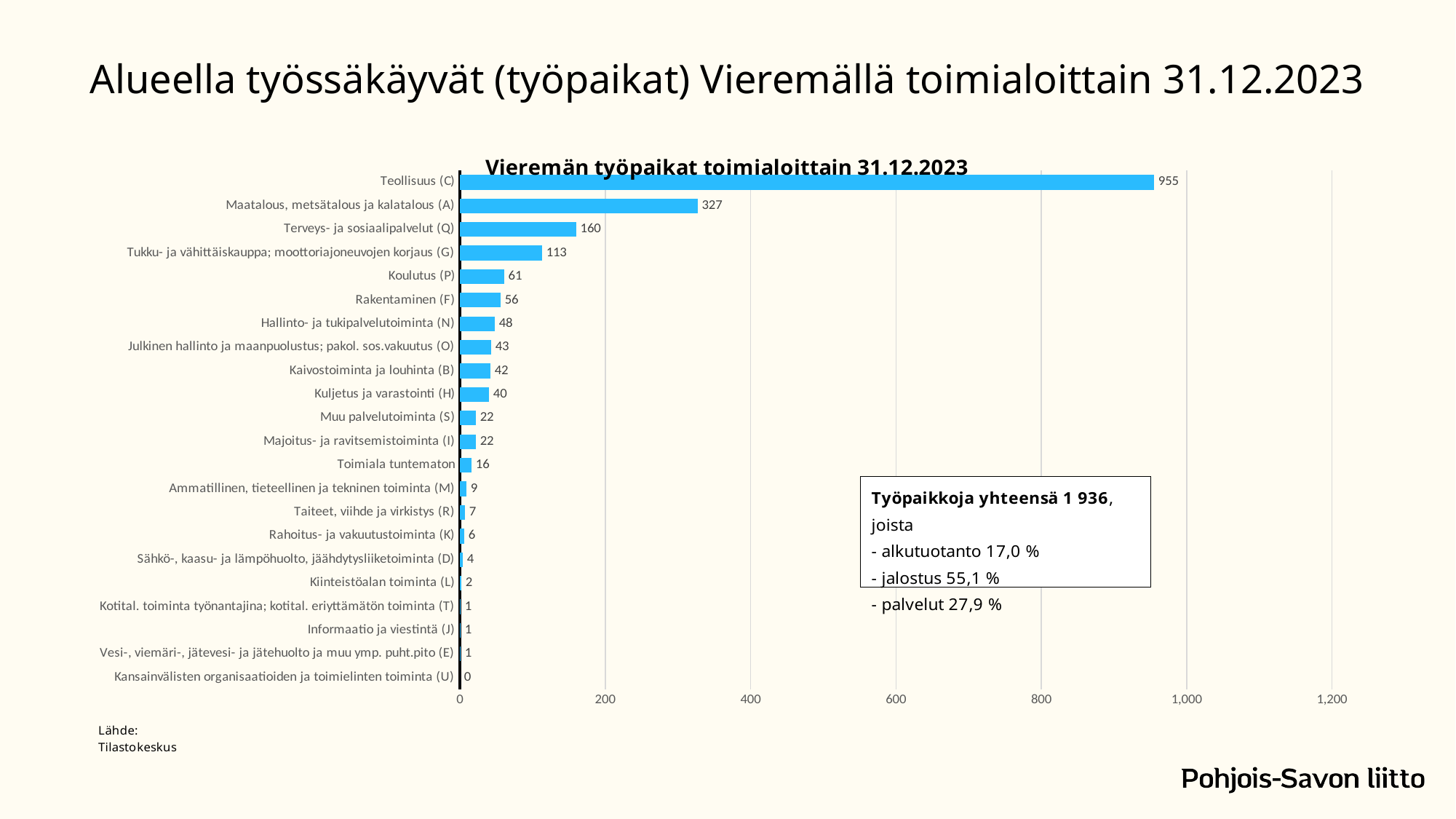
What is the value for Koulutus (P)? 61 What is the value for Teollisuus (C)? 955 What is the value for Maatalous, metsätalous ja kalatalous (A)? 327 Is the value for Teollisuus (C) greater or less than 800? greater What kind of chart is shown on the slide? bar chart What is the title of the chart? Vieremän työpaikat toimialoittain 31.12.2023 What is the difference between the values for Teollisuus (C) and Maatalous, metsätalous ja kalatalous (A)? 628 Which is larger, the value for Terveys- ja sosiaalipalvelut (Q) or Tukku- ja vähittäiskauppa; moottoriajoneuvojen korjaus (G)? Terveys- ja sosiaalipalvelut (Q) How many categories are shown in the chart? 22 What is the value for Kaivostoiminta ja louhinta (B)? 42 Which category has the lowest value? Kansainvälisten organisaatioiden ja toimielinten toiminta (U) Which category has the highest value? Teollisuus (C)